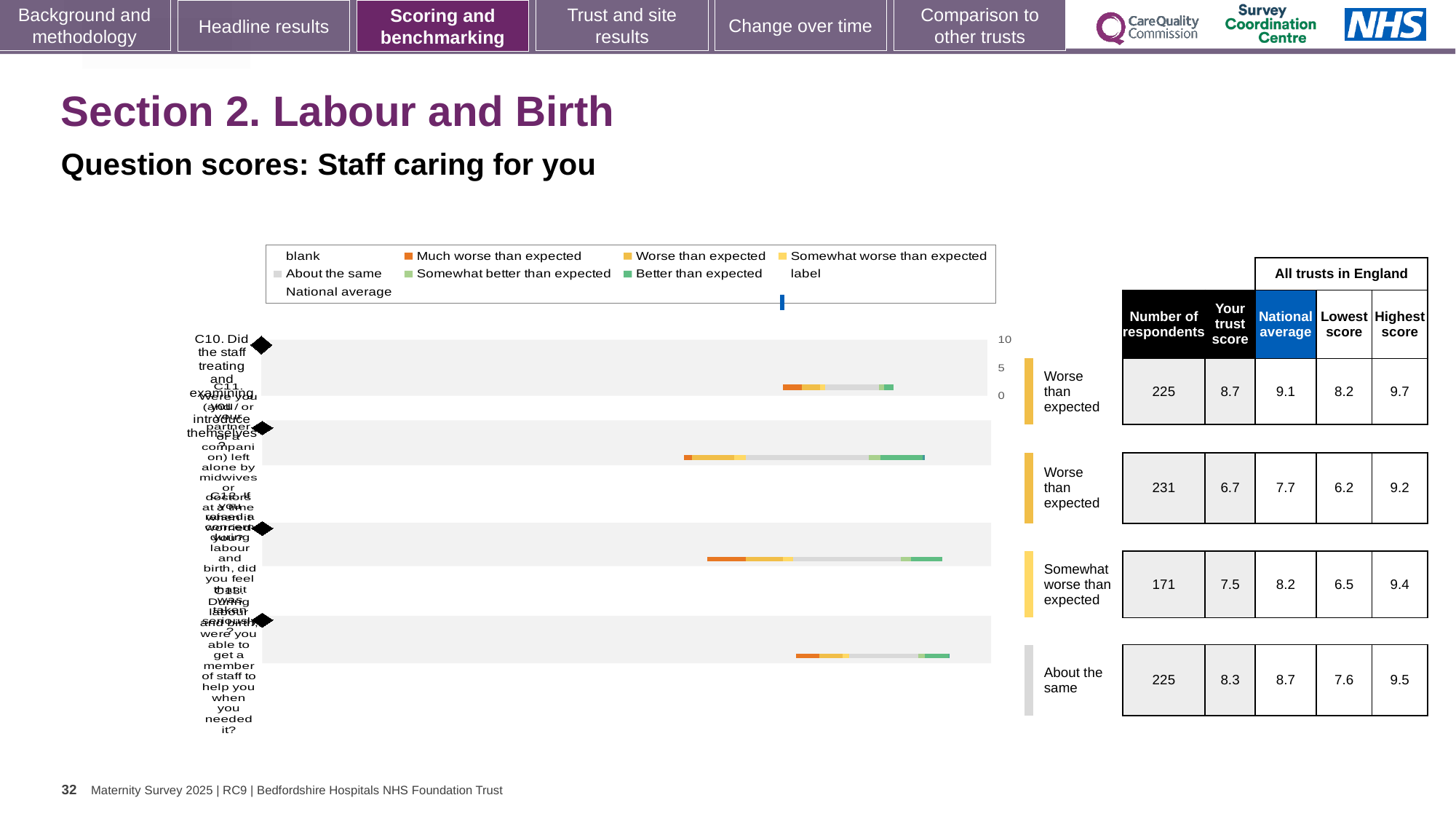
What kind of chart is shown on the slide? bar chart Which row has the highest trust score in the table? the first row (8.7) In the table, what is the national average for the third row? 8.2 In the table, what is the trust score for the second row? 6.7 For the second row, what is the difference between the national average and the trust score? 1.0 For the first row, is the trust score or the national average larger? national average How many question rows (bars) are plotted in the chart? 4 In the table, what is the highest score for the fourth row? 9.5 Which row has the lowest trust score in the table? the second row (6.7) In the table, what is the number of respondents for the first row (C10)? 225 What rating label is shown next to the third row? Somewhat worse than expected What is the subtitle of the chart section on the slide? Question scores: Staff caring for you